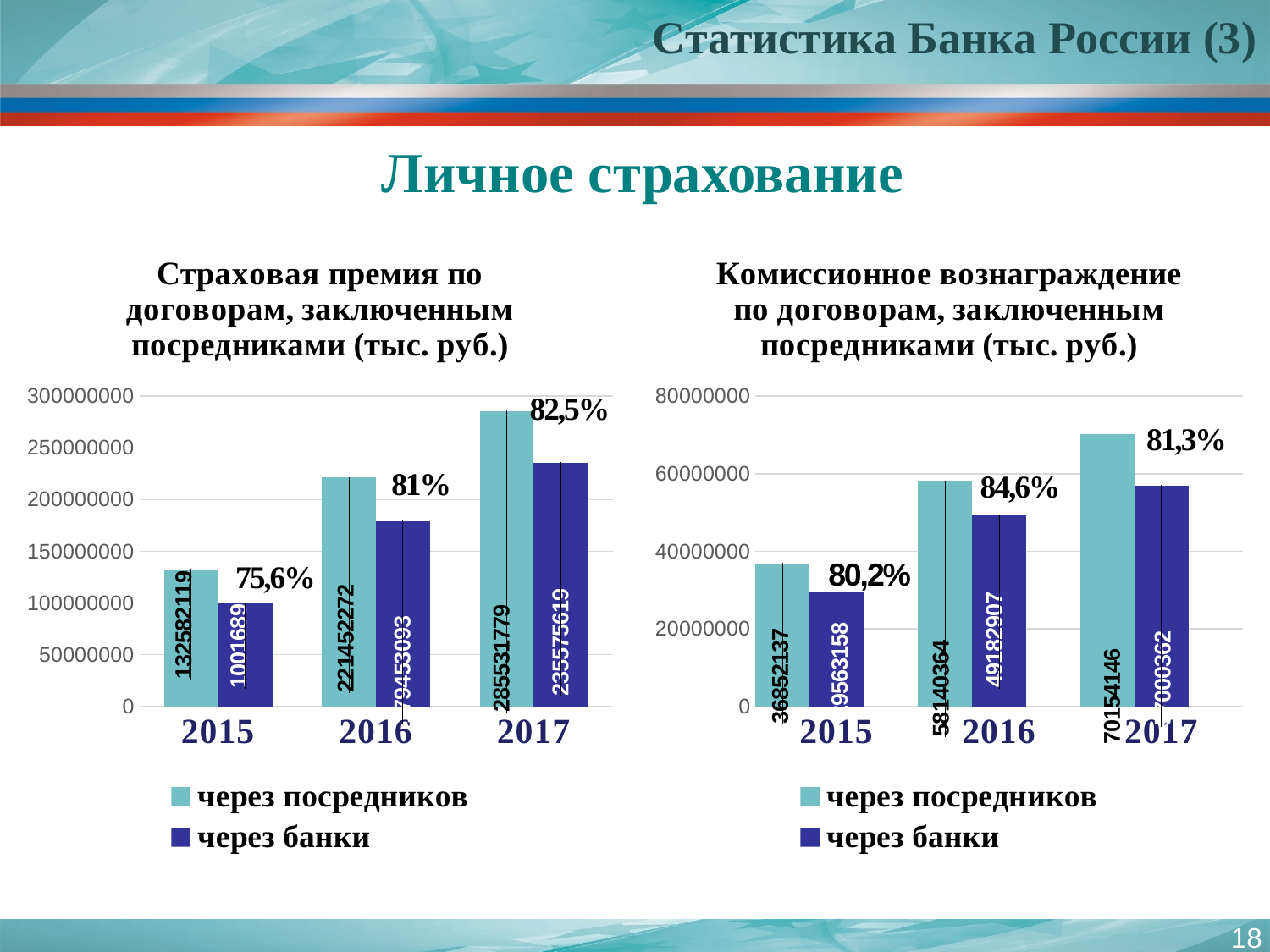
In the left chart (Страховая премия), is the value for 'через банки' in 2016 greater or less than 150000000? greater In the left chart (Страховая премия), do the 'через посредников' values rise or fall from 2015 to 2017? rise In the left chart (Страховая премия), what is the value for 'через посредников' in 2015? 132582119 In the right chart (Комиссионное вознаграждение), which year has the highest 'через посредников' value? 2017 How many series does the legend of the left chart (Страховая премия) list? 2 In the right chart (Комиссионное вознаграждение), what is the value for 'через посредников' in 2017? 70154146 How many years are shown on the x axis of the right chart (Комиссионное вознаграждение)? 3 In the left chart (Страховая премия), what is the difference between 'через посредников' and 'через банки' in 2017? 49956160 What type of chart is the left chart (Страховая премия)? bar chart In the right chart (Комиссионное вознаграждение), what is the value for 'через банки' in 2016? 49182907 In the left chart (Страховая премия по договорам, заключенным посредниками), what is the value for 'через посредников' in 2017? 285531779 In the right chart (Комиссионное вознаграждение), what percentage label is shown above the 2016 bars? 84,6%